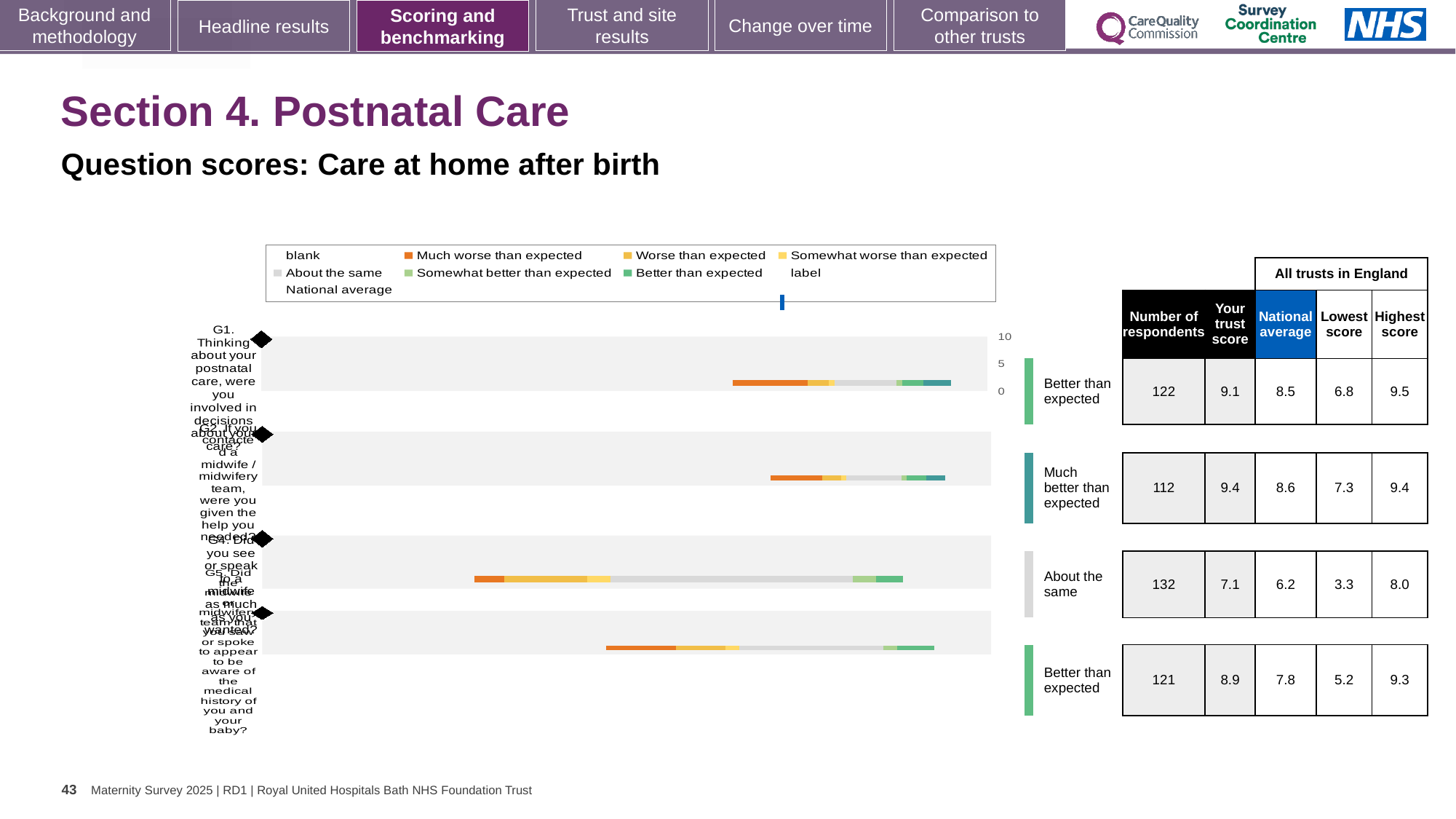
In the table, what is the number of respondents for the first row (G1, involved in decisions about your care)? 122 What colour represents 'Much worse than expected' in the legend? orange Which is larger: the trust score for the first row or the trust score for the fourth row? the first row (9.1) For the first row, what is the difference between the trust score (9.1) and the national average (8.5)? 0.6 Which row has the highest 'Your trust score' in the table? the second row (9.4) In the table, what is the trust score for the second row (rated 'Much better than expected')? 9.4 What benchmark category is shown for the third row of the chart? About the same Which row has the lowest value in the 'Lowest score' column? the third row (3.3) How many question rows (bars) are plotted in the chart? 4 In the table, what is the national average for the third row (rated 'About the same')? 6.2 What kind of chart is shown on the slide? bar chart In the table, what is the highest score in England for the fourth row? 9.3